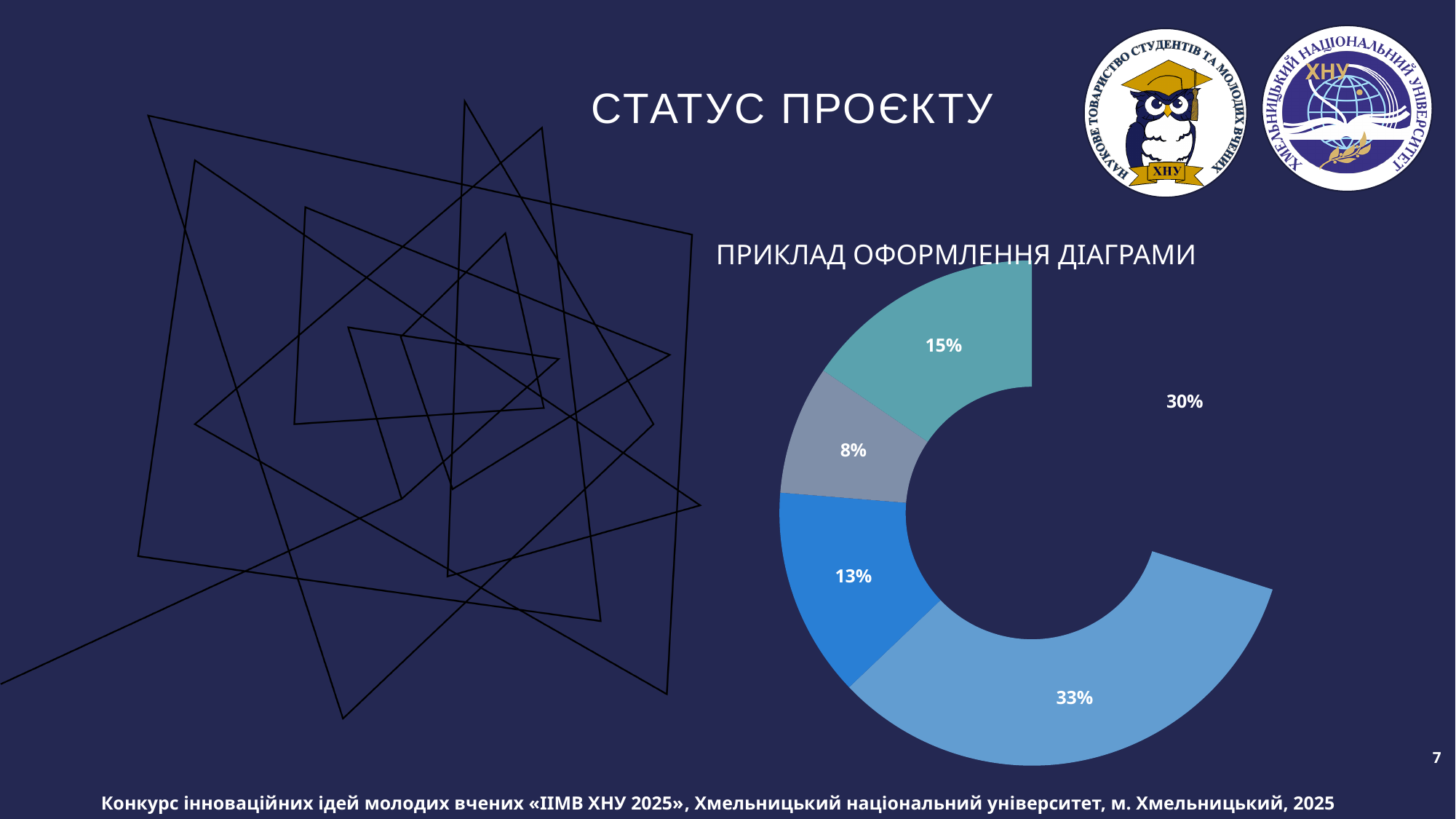
What percentage is labelled on the teal slice at the top of the doughnut? 15% What percentage is labelled on the bright blue slice on the lower left of the doughnut? 13% What is the title shown above the chart? ПРИКЛАД ОФОРМЛЕННЯ ДІАГРАМИ Which is larger, the teal slice (15%) or the bright blue slice (13%)? The teal slice (15%) What is the largest percentage value labelled on the chart? 33% What percentage is labelled on the light blue slice at the bottom of the doughnut? 33% What kind of chart is shown on the slide? Doughnut (pie) chart What is the smallest percentage value labelled on the chart? 8% What percentage label appears in the gap on the right side of the doughnut? 30% What percentage is labelled on the grey slice on the left of the doughnut? 8% How many percentage labels are shown on the chart? 5 What is the difference between the 33% slice and the 30% slice? 3 percentage points